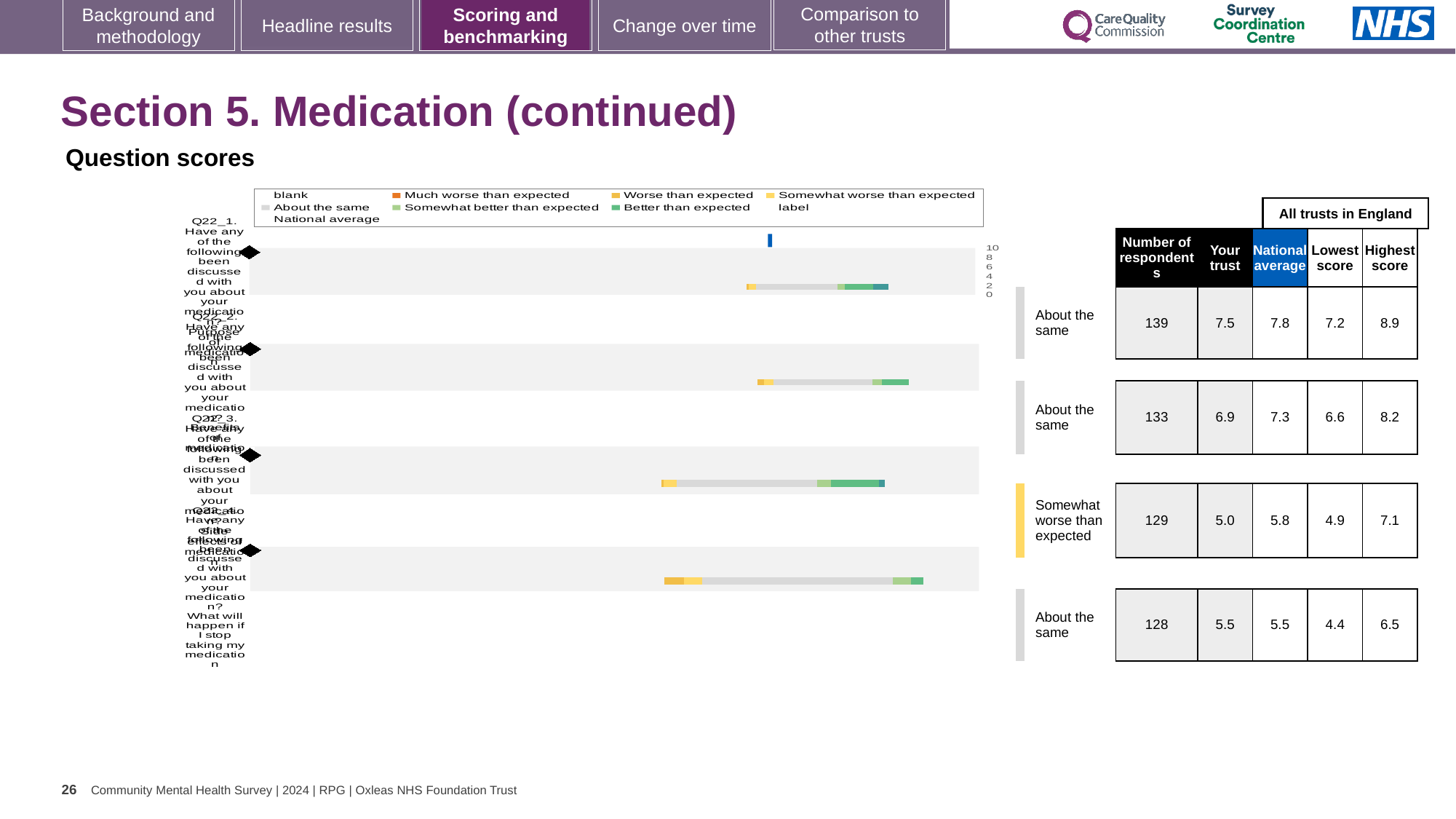
In the table, which row has the lowest 'Your trust' score? Q22_3 (third row), 5.0 In the table, what is the difference between the national average and 'Your trust' score in the third row (Q22_3)? 0.8 Which row in the table is labelled 'Somewhat worse than expected'? the third row (Q22_3) How many question rows (Q22_1 to Q22_4) are plotted in the chart? 4 In the table, which row has the highest 'Your trust' score? Q22_1 (first row), 7.5 In the table, what is the national average in the third row (Q22_3)? 5.8 In the table, what is the 'Your trust' score in the first row (Q22_1)? 7.5 Which legend entry is shown in orange in the chart legend? Much worse than expected What kind of chart is shown under 'Question scores'? bar chart In the table, is the 'Your trust' score larger than the national average in the second row (Q22_2)? No, 6.9 is less than 7.3 Which legend entry is shown in dark green in the chart legend? Better than expected In the table, what is the number of respondents in the fourth row (Q22_4, 'What will happen if I stop taking my medication')? 128